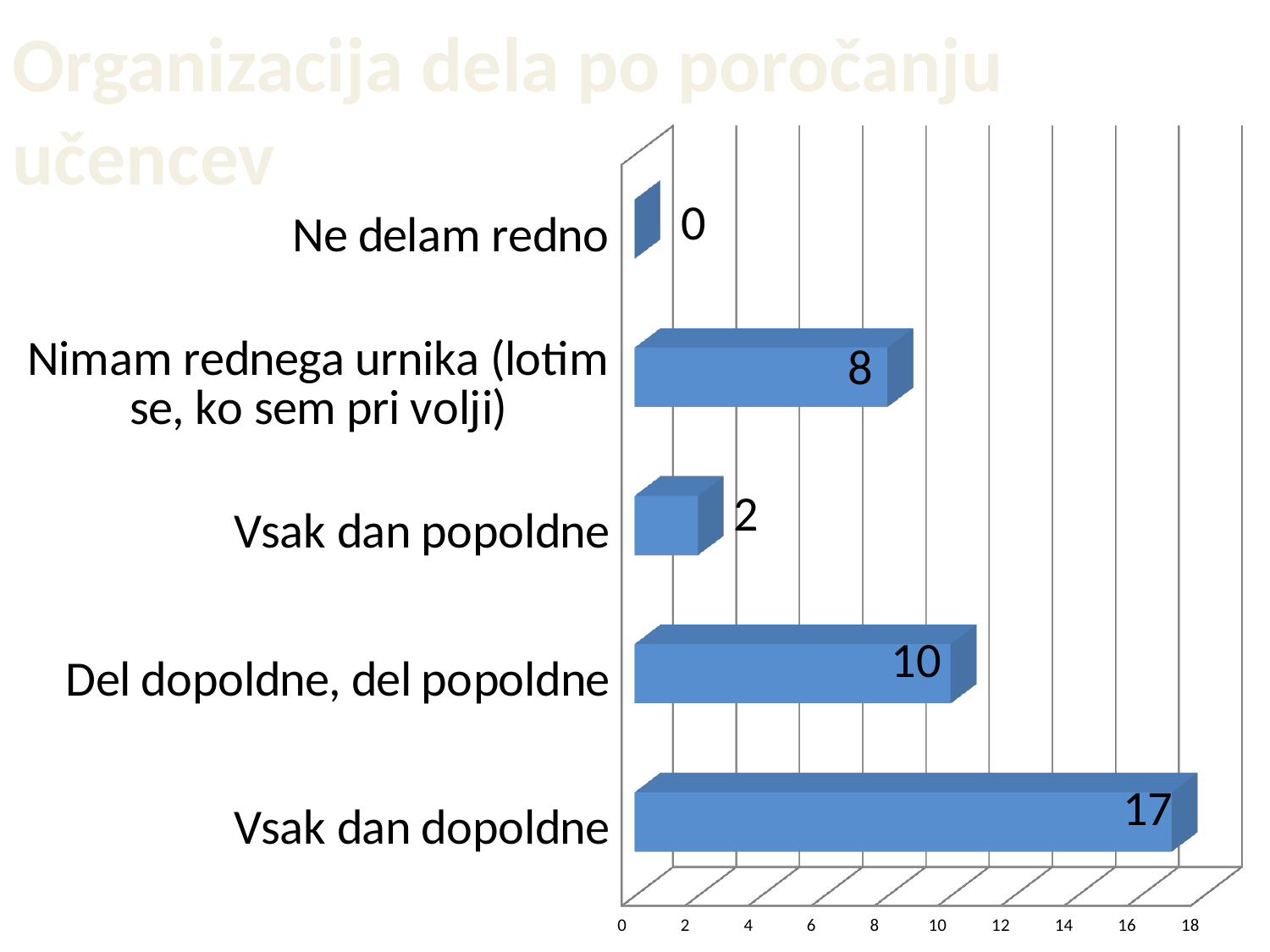
What is the difference between the values for "Vsak dan dopoldne" and "Del dopoldne, del popoldne"? 7 What is the value for "Vsak dan popoldne"? 2 Which is larger, the value for "Nimam rednega urnika (lotim se, ko sem pri volji)" or the value for "Vsak dan popoldne"? Nimam rednega urnika (lotim se, ko sem pri volji) What is the value for "Del dopoldne, del popoldne"? 10 What is the value for "Vsak dan dopoldne"? 17 What is the value for "Nimam rednega urnika (lotim se, ko sem pri volji)"? 8 What is the value for "Ne delam redno"? 0 Which category has the lowest value? Ne delam redno Which category has the highest value? Vsak dan dopoldne What kind of chart is shown on the slide? Bar chart How many categories are shown in the chart? 5 What is the title of the slide? Organizacija dela po poročanju učencev